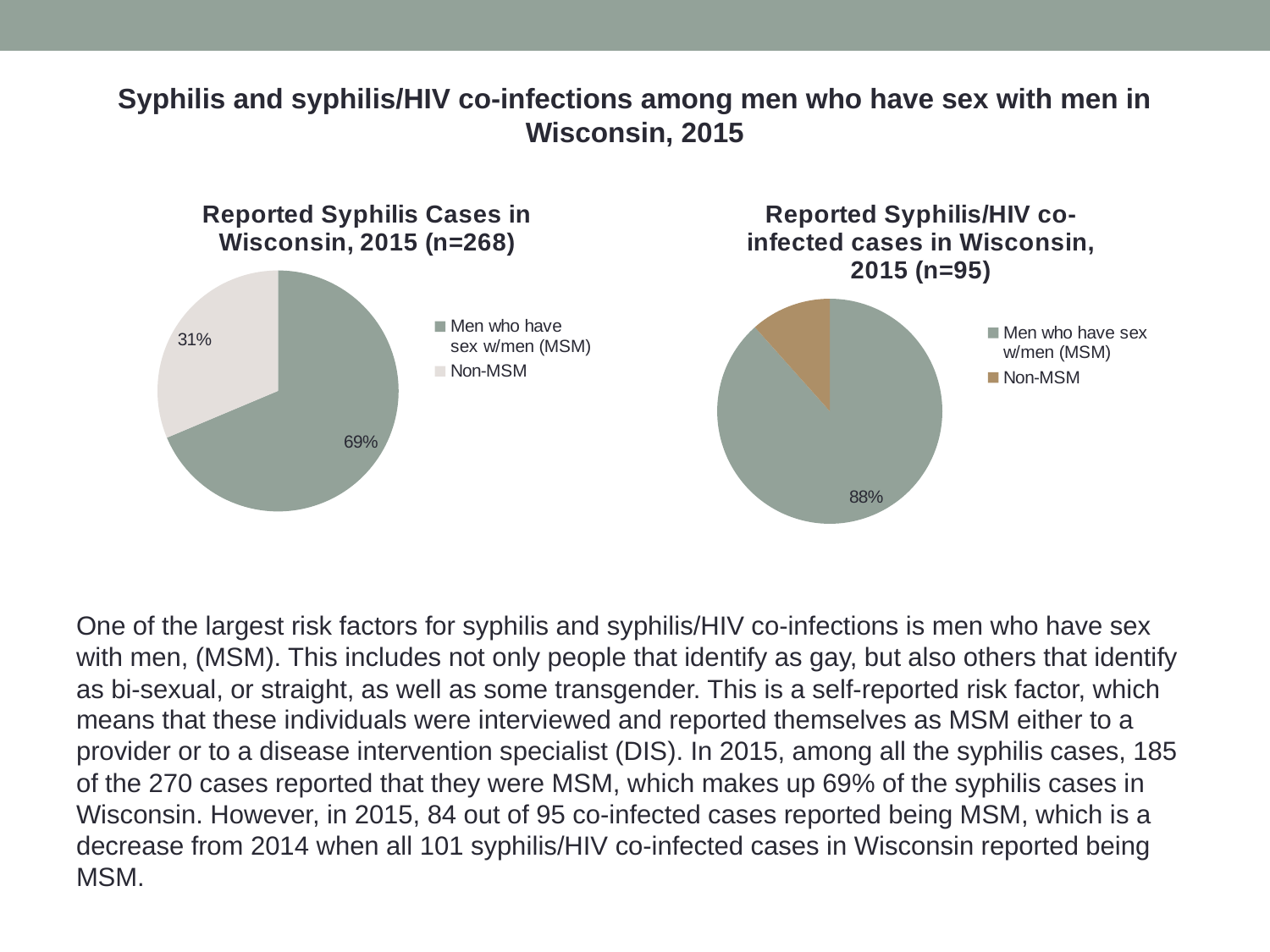
In the 'Reported Syphilis/HIV co-infected cases in Wisconsin, 2015 (n=95)' chart, what share of cases is Men who have sex w/men (MSM)? 88% What is the title of the pie chart on the right side of the slide? Reported Syphilis/HIV co-infected cases in Wisconsin, 2015 (n=95) In the 'Reported Syphilis Cases in Wisconsin, 2015 (n=268)' chart, what share of cases is Non-MSM? 31% In the 'Reported Syphilis Cases in Wisconsin, 2015 (n=268)' chart, is the Non-MSM share greater or less than 50%? less In the 'Reported Syphilis Cases in Wisconsin, 2015 (n=268)' chart, what is the difference in percentage points between the MSM and Non-MSM slices? 38 percentage points How many categories does the legend of the 'Reported Syphilis/HIV co-infected cases in Wisconsin, 2015 (n=95)' chart list? 2 In the 'Reported Syphilis Cases in Wisconsin, 2015 (n=268)' chart, which category has the largest slice? Men who have sex w/men (MSM) In the 'Reported Syphilis/HIV co-infected cases in Wisconsin, 2015 (n=95)' chart, which category has the smallest slice? Non-MSM In the 'Reported Syphilis Cases in Wisconsin, 2015 (n=268)' chart, what share of cases is Men who have sex w/men (MSM)? 69% Which chart shows a larger MSM share: the 'Reported Syphilis Cases' chart or the 'Reported Syphilis/HIV co-infected cases' chart? Reported Syphilis/HIV co-infected cases In the 'Reported Syphilis Cases in Wisconsin, 2015 (n=268)' chart, which category has the smallest slice? Non-MSM What type of chart is the 'Reported Syphilis Cases in Wisconsin, 2015 (n=268)' chart? Pie chart